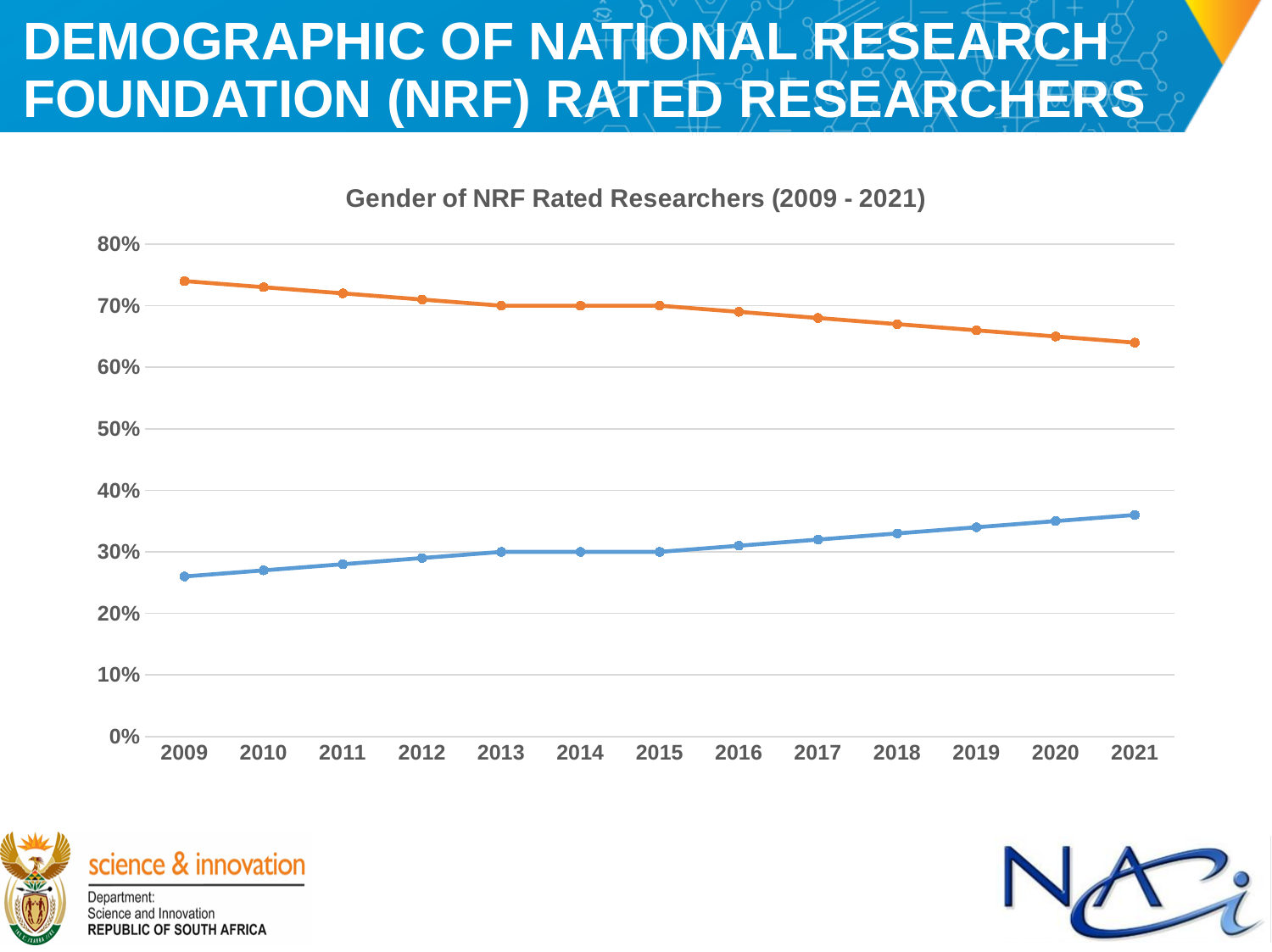
Does the orange line rise or fall from 2009 to 2021? fall Is the value of the orange line in 2009 greater or less than 70%? greater In which year does the blue line reach its lowest value? 2009 What kind of chart is shown on the slide? line chart What is the title of the chart? Gender of NRF Rated Researchers (2009 - 2021) In which year does the orange line reach its highest value? 2009 Does the blue line rise or fall from 2009 to 2021? rise In 2021, which line has the higher value, the orange line or the blue line? orange line How many years are plotted along the x axis of the chart? 13 Is the value of the blue line in 2009 greater or less than 30%? less Is the value of the orange line in 2021 greater or less than 70%? less